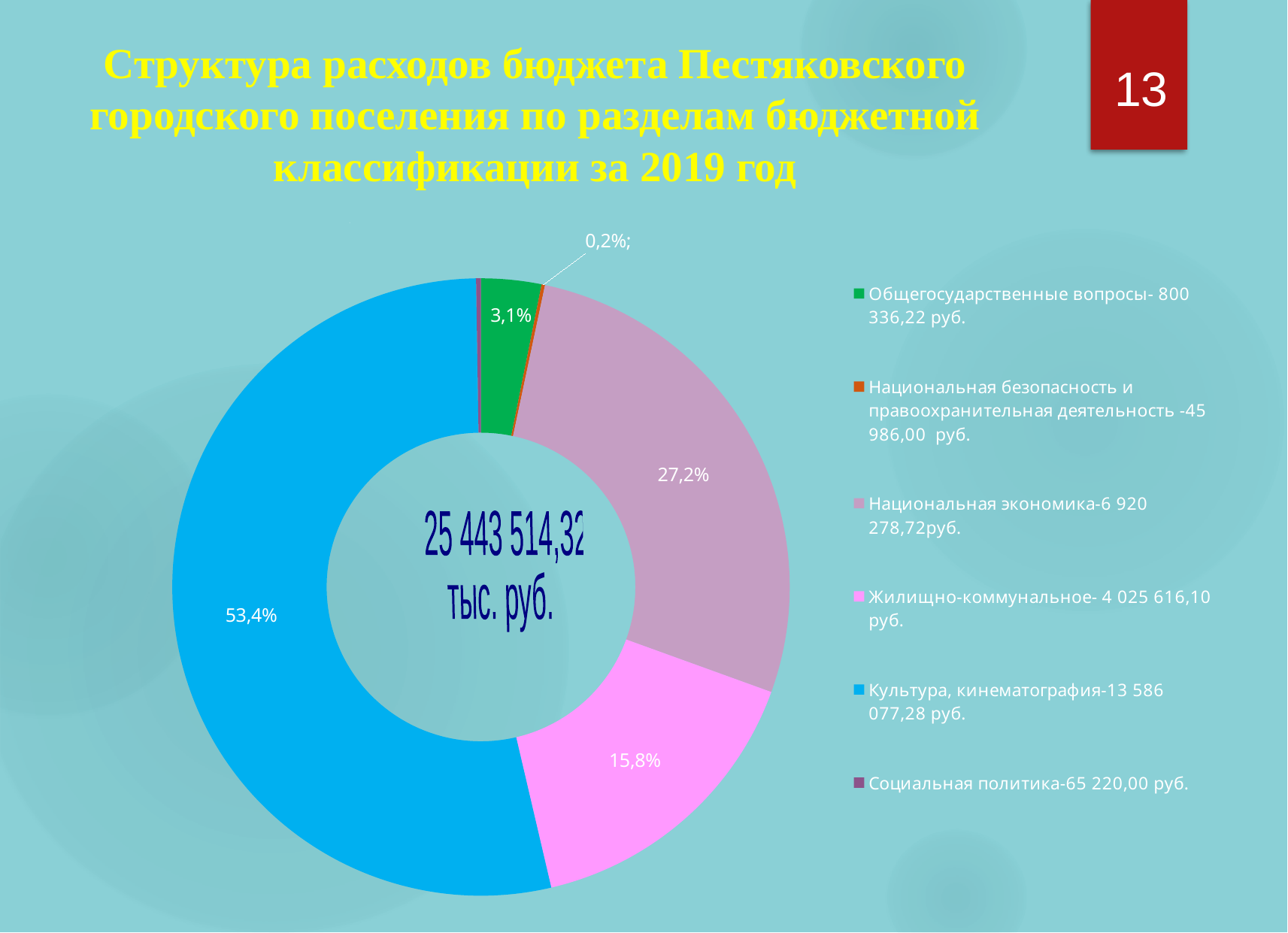
What percentage share is shown for Жилищно-коммунальное? 15,8% Which is larger: the share for Национальная экономика or the share for Жилищно-коммунальное? Национальная экономика What is the difference in percentage points between the shares for Культура, кинематография and Национальная экономика? 26,2 How many categories does the legend of the chart list? 6 Which category has the largest share of the chart? Культура, кинематография What percentage share is shown for Национальная безопасность и правоохранительная деятельность? 0,2% What total amount is printed in the centre of the chart? 25 443 514,32 тыс. руб. What percentage share is shown for Национальная экономика? 27,2% What kind of chart is shown on the slide? Doughnut (pie) chart What amount in rubles does the legend give for Социальная политика? 65 220,00 руб. What percentage share is shown for Общегосударственные вопросы? 3,1% What percentage share is shown for Культура, кинематография? 53,4%